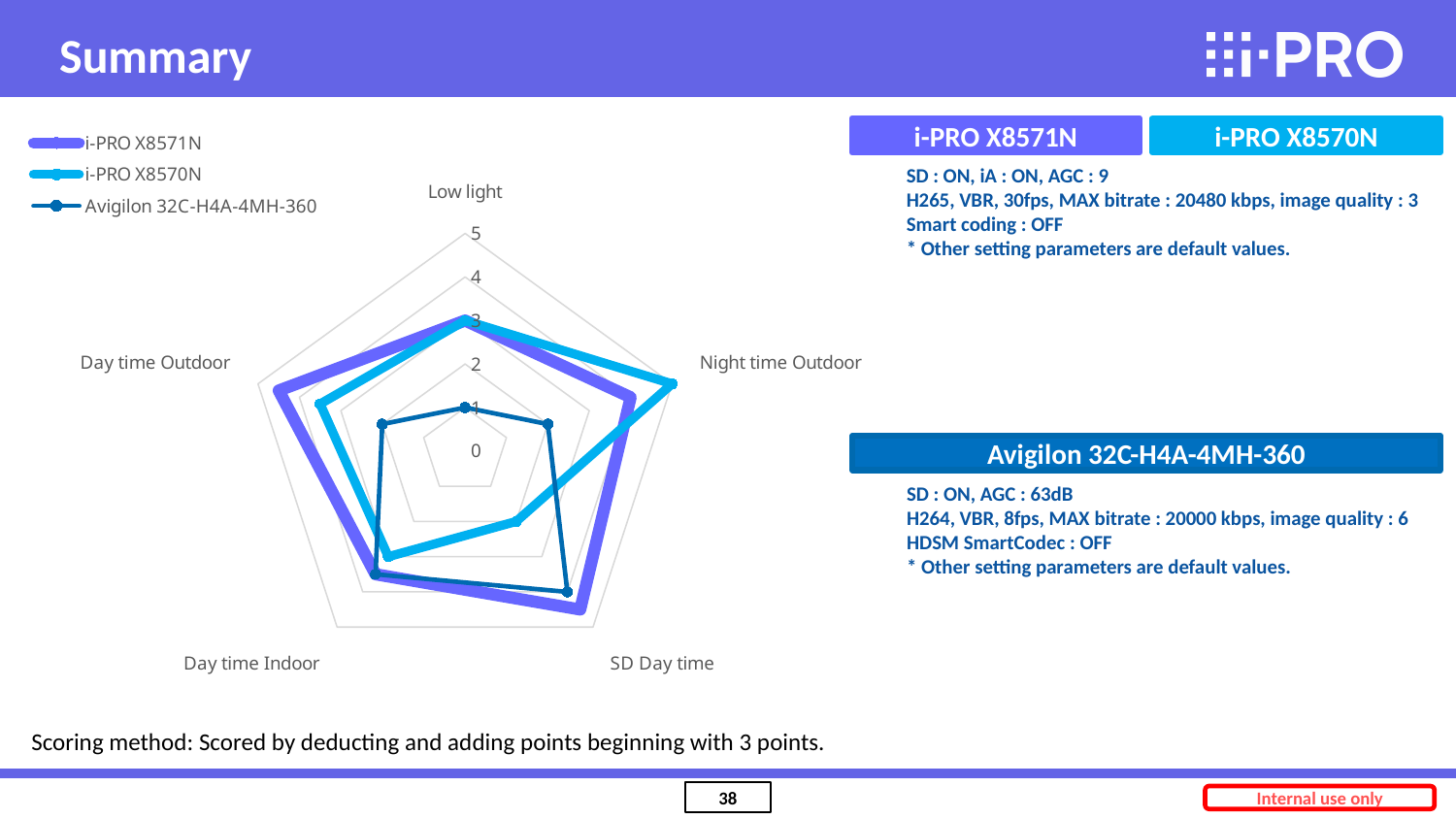
Which series is drawn with circular markers on the radar chart? Avigilon 32C-H4A-4MH-360 Is the value for i-PRO X8571N on the SD Day time axis greater or less than 4? greater Which series has the lowest value on the SD Day time axis? i-PRO X8570N How many categories (axes) does the radar chart have? 5 What is the maximum value shown on the radar chart's scale? 5 Is the value for Avigilon 32C-H4A-4MH-360 on the Low light axis greater or less than 2? less Which series has the highest value on the Night time Outdoor axis? i-PRO X8570N How many series does the legend of the radar chart list? 3 On the Day time Outdoor axis, which is larger: i-PRO X8571N or Avigilon 32C-H4A-4MH-360? i-PRO X8571N What kind of chart is shown on the slide? Radar chart Is the value for i-PRO X8570N on the Night time Outdoor axis greater or less than 4? greater